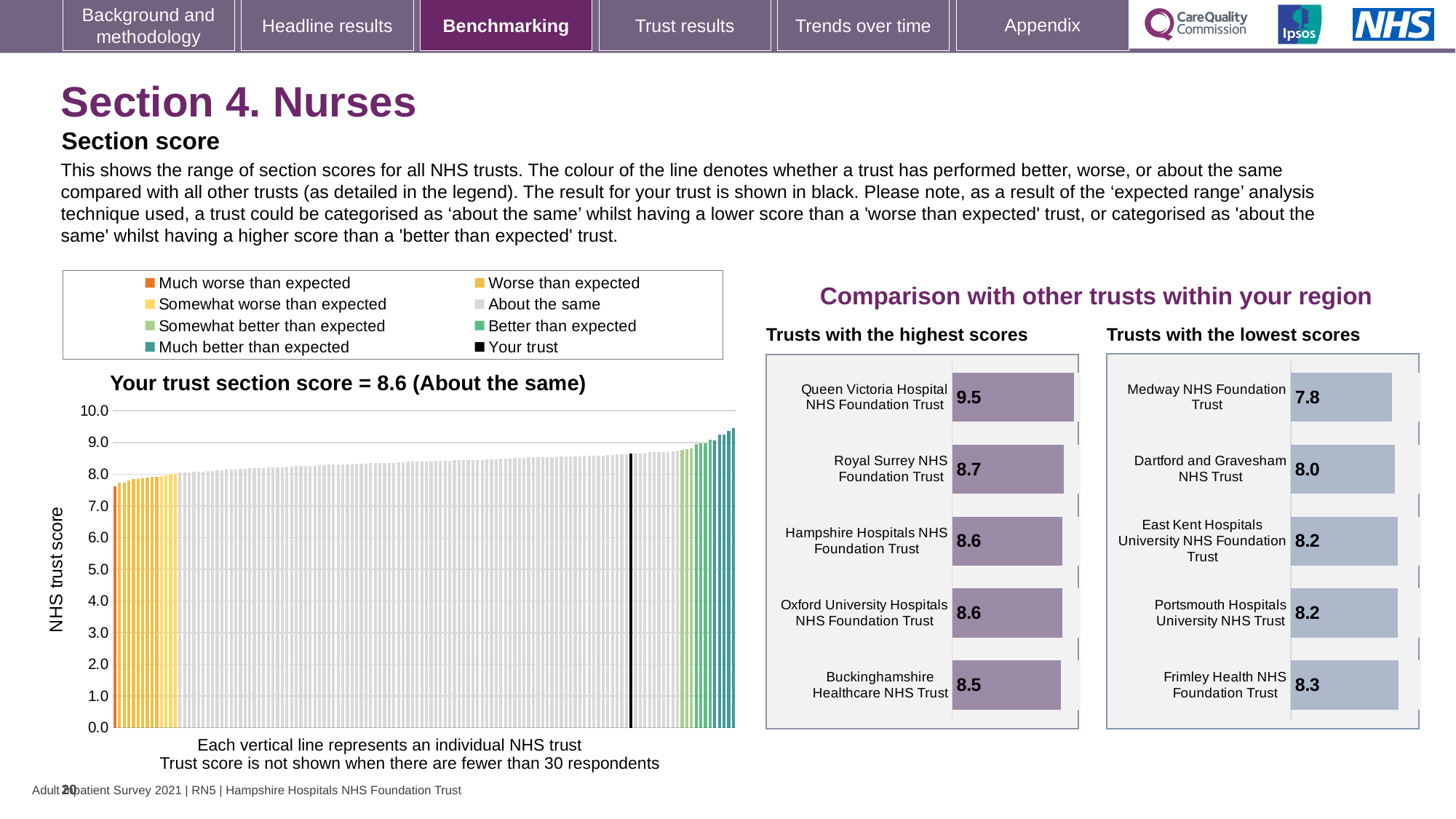
In the 'Trusts with the lowest scores' chart, what is the score for Frimley Health NHS Foundation Trust? 8.3 In the main 'Your trust section score' chart, is the value of the lowest-scoring trust (the leftmost bar) greater or less than 8.0? less In the 'Trusts with the highest scores' chart, what is the score for Royal Surrey NHS Foundation Trust? 8.7 In the 'Trusts with the highest scores' chart, which trust has the highest score? Queen Victoria Hospital NHS Foundation Trust How many entries does the legend above the main 'Your trust section score' chart list? 8 In the 'Trusts with the highest scores' chart, what is the score for Queen Victoria Hospital NHS Foundation Trust? 9.5 In the 'Trusts with the highest scores' chart, what is the difference between the scores of Queen Victoria Hospital NHS Foundation Trust and Buckinghamshire Healthcare NHS Trust? 1.0 In the 'Trusts with the lowest scores' chart, which has the larger score: Dartford and Gravesham NHS Trust or Frimley Health NHS Foundation Trust? Frimley Health NHS Foundation Trust In the 'Trusts with the lowest scores' chart, what is the score for Medway NHS Foundation Trust? 7.8 How many trusts are shown in the 'Trusts with the lowest scores' chart? 5 In the main 'Your trust section score' chart, do the trust scores rise or fall from left to right along the x axis? rise In the 'Trusts with the lowest scores' chart, which trust has the lowest score? Medway NHS Foundation Trust